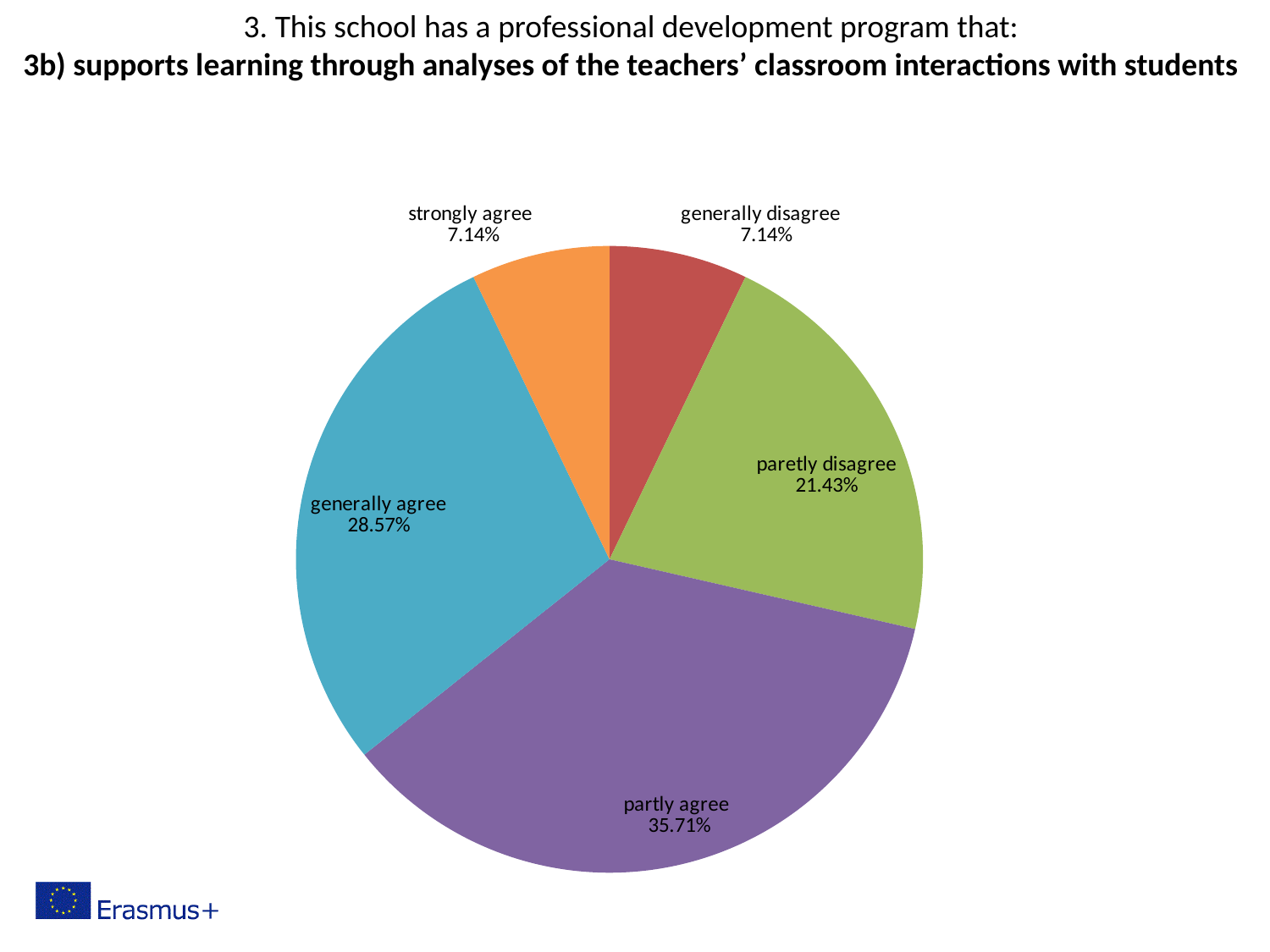
What percentage of respondents chose 'generally agree'? 28.57% What percentage of respondents chose 'strongly agree'? 7.14% Which response category has the largest share of the pie? partly agree Which two response categories have the same share of 7.14%? strongly agree and generally disagree What is the combined share of 'strongly agree' and 'generally disagree'? 14.28% How many slices does the pie chart have? 5 What kind of chart is shown on the slide? pie chart Which is larger, the share for 'generally agree' or the share for 'paretly disagree'? generally agree What colour is the 'partly agree' slice? purple What percentage of respondents chose 'partly agree'? 35.71% What is the difference in percentage points between 'partly agree' and 'generally agree'? 7.14 What percentage of respondents chose 'paretly disagree'? 21.43%